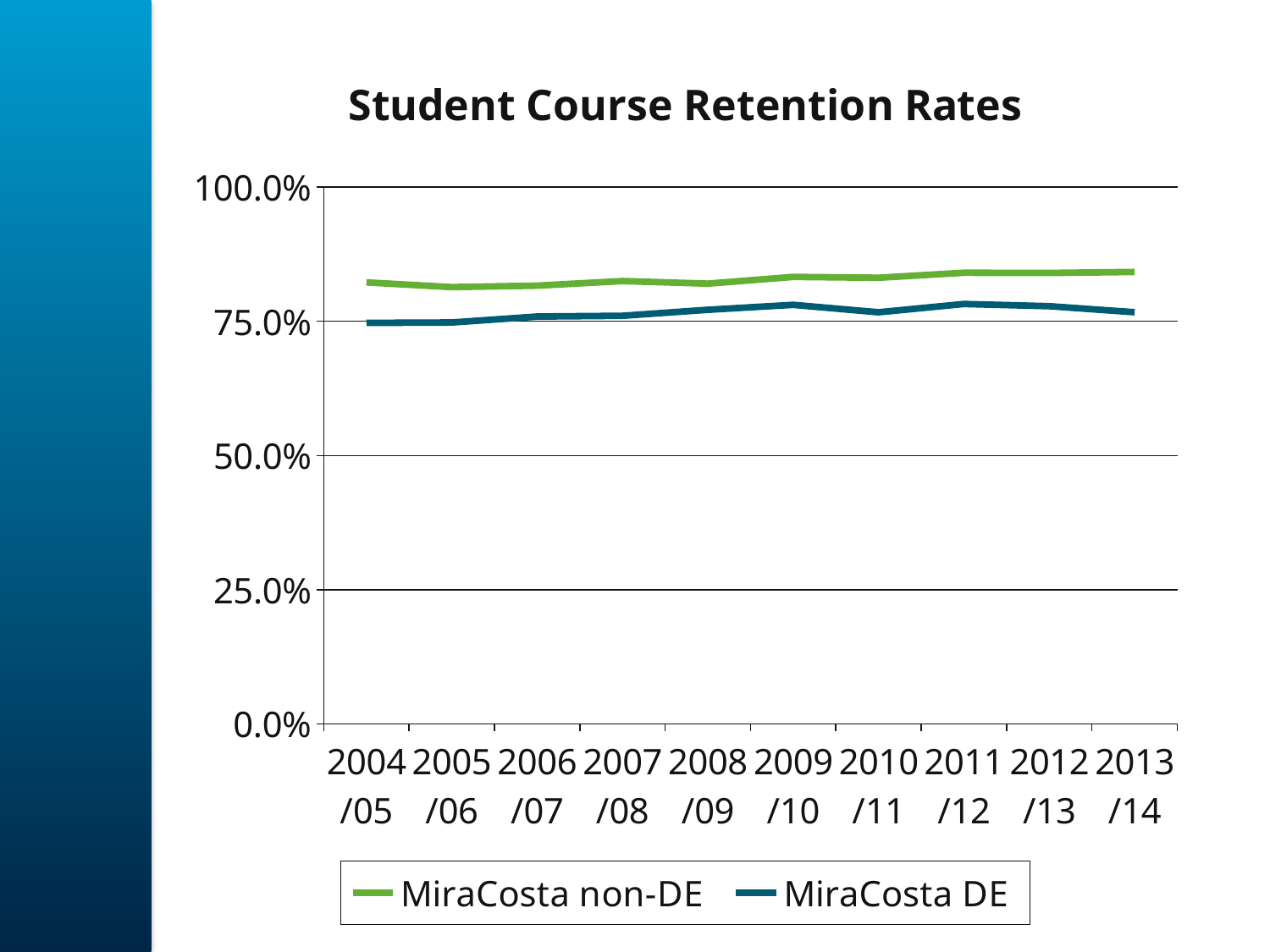
Is the MiraCosta DE retention rate for 2009/10 greater or less than 75.0%? greater Is the MiraCosta DE retention rate for 2011/12 greater or less than 50.0%? greater Is the MiraCosta non-DE retention rate for 2013/14 greater or less than 100.0%? less Which series has the higher retention rate in 2013/14, MiraCosta non-DE or MiraCosta DE? MiraCosta non-DE How many series does the legend list? 2 What kind of chart is shown on the slide? line chart Does the MiraCosta non-DE retention rate rise or fall overall from 2004/05 to 2013/14? rise Which series has the higher retention rate in 2004/05, MiraCosta non-DE or MiraCosta DE? MiraCosta non-DE How many academic years are plotted along the x axis? 10 What is the title of the chart? Student Course Retention Rates Which series is drawn in green? MiraCosta non-DE